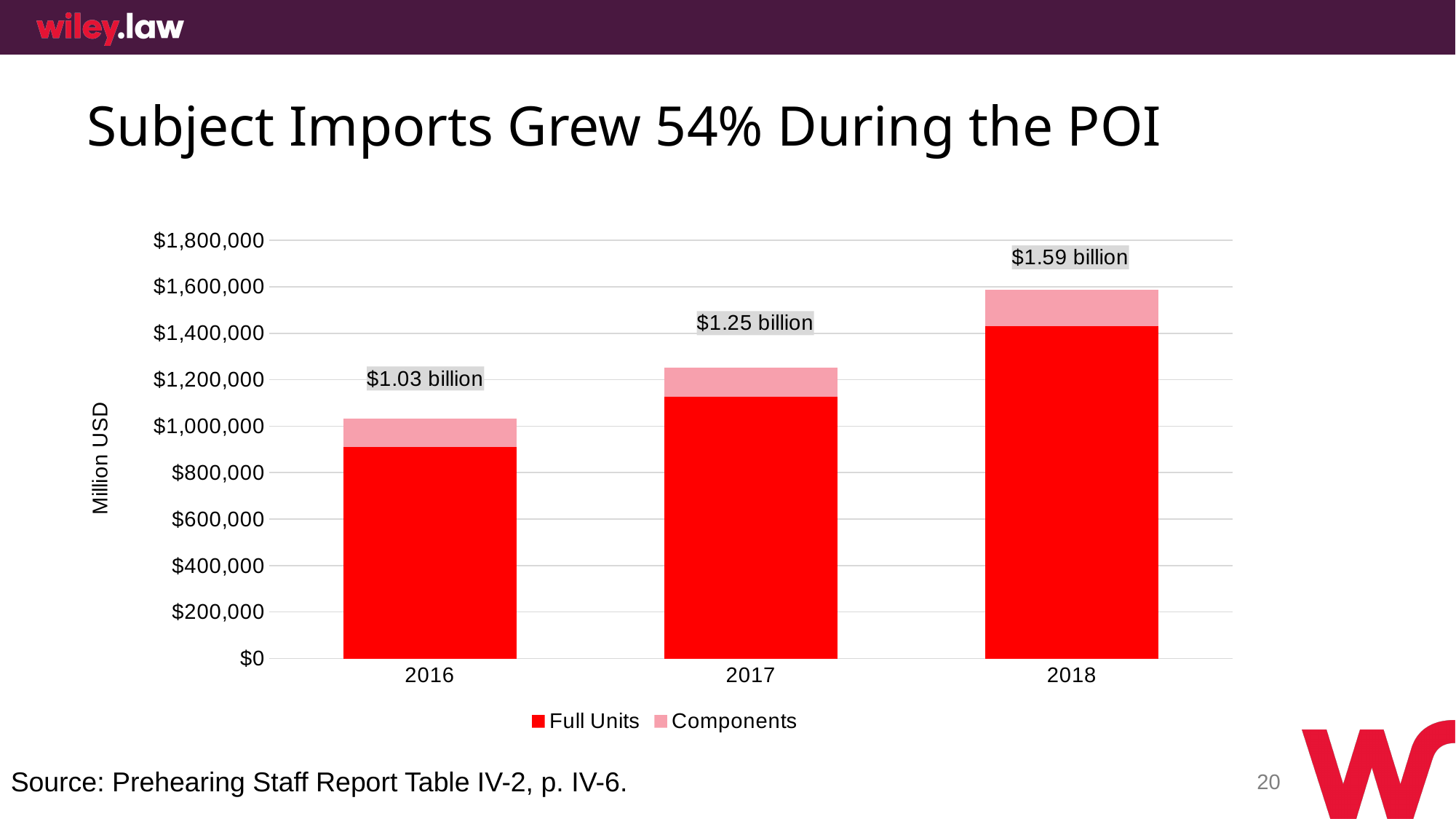
What is the total value labelled on the bar for 2016? $1.03 billion What is the total value labelled on the bar for 2017? $1.25 billion Which year has the lowest total subject imports? 2016 How many series does the legend list? 2 Is the total for 2017 larger or smaller than the total for 2016? larger Which year has the highest total subject imports? 2018 Is the Full Units value for 2017 greater or less than $1,000,000? greater What kind of chart is shown on the slide? stacked bar chart Is the Full Units value for 2016 greater or less than $1,000,000? less How many years are shown on the x axis? 3 Do total subject imports rise or fall from 2016 to 2018? rise What is the total value labelled on the bar for 2018? $1.59 billion